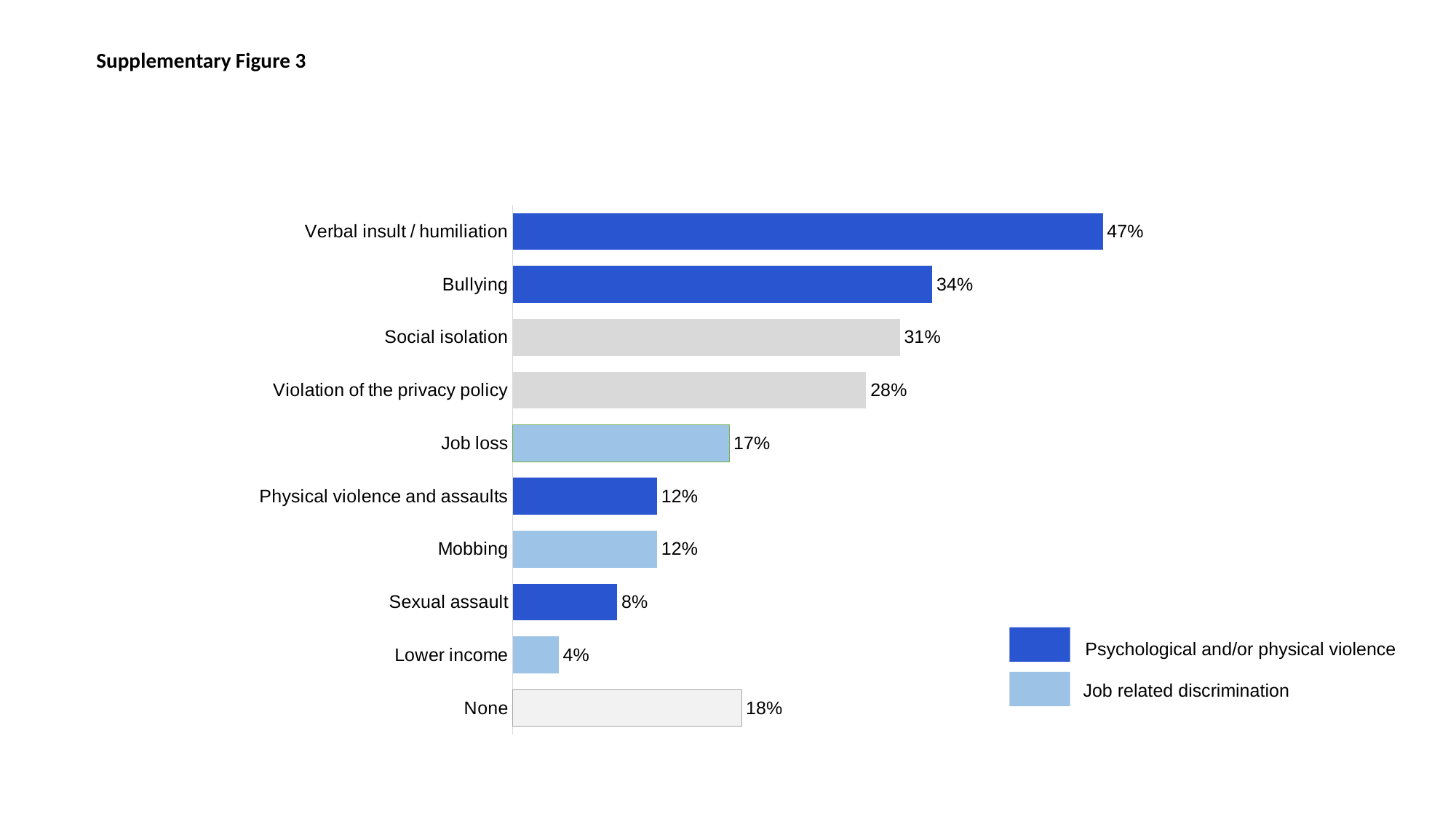
What is the value for Job loss? 17% Which category has the highest value? Verbal insult / humiliation How many categories are shown on the chart? 10 What is the value for None? 18% What is the difference between the values for Social isolation and Violation of the privacy policy? 3% Which is larger, the value for Sexual assault or the value for Lower income? Sexual assault What kind of chart is shown on the slide? Bar chart What is the value for Verbal insult / humiliation? 47% Which category has the lowest value? Lower income What is the difference between the values for Verbal insult / humiliation and Bullying? 13% How many series does the legend list? 2 What is the value for Social isolation? 31%